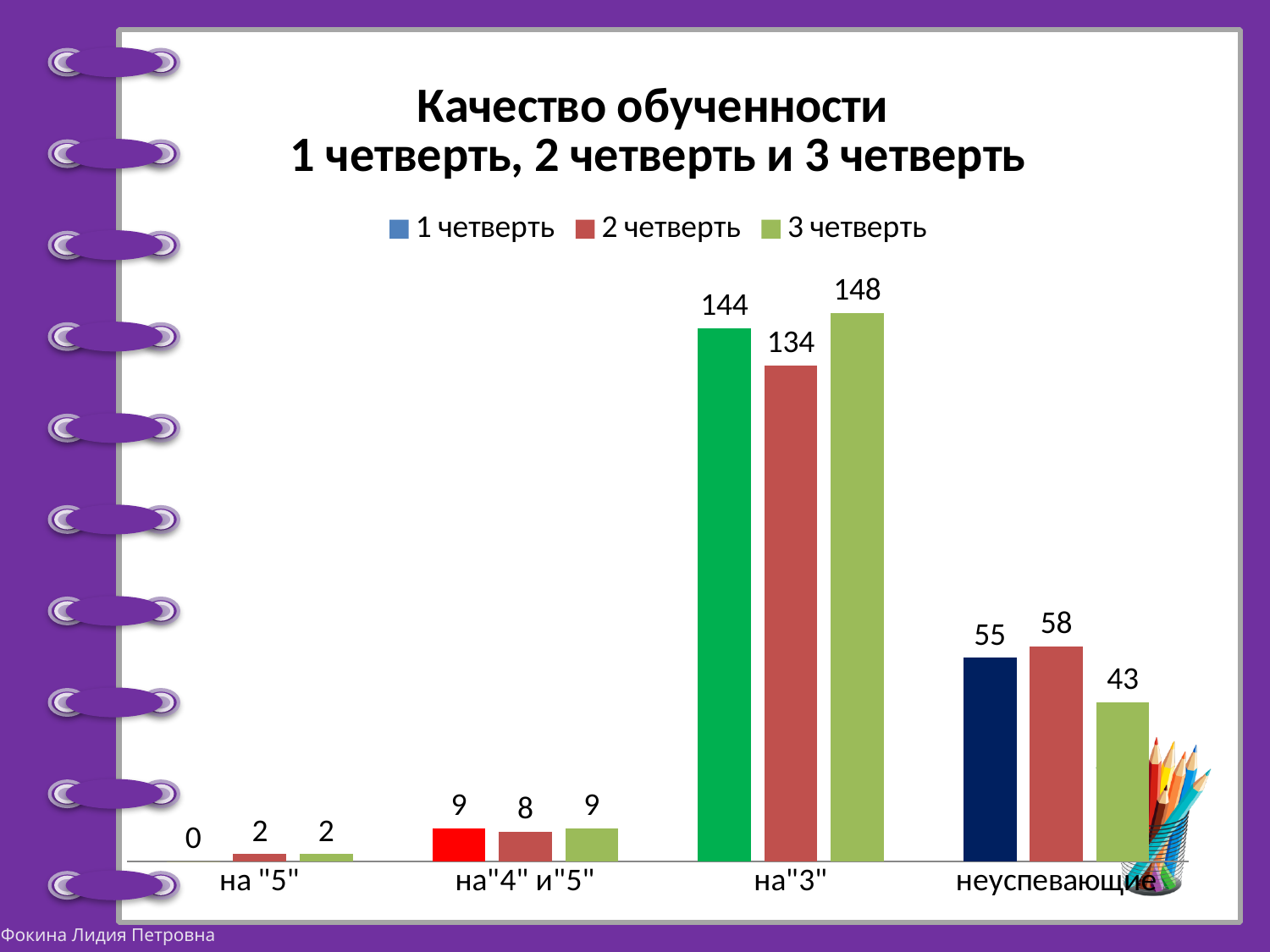
How many categories are shown on the x axis? 4 What kind of chart is shown on the slide? bar chart What is the value for 2 четверть in the неуспевающие category? 58 What is the difference between the 3 четверть and 2 четверть values in the на"3" category? 14 In the неуспевающие category, which is larger: the value for 2 четверть or for 3 четверть? 2 четверть What is the value for 1 четверть in the на "5" category? 0 What is the value for 2 четверть in the на"4" и"5" category? 8 What is the value for 3 четверть in the на"3" category? 148 Which category has the lowest value for 3 четверть? на "5" Which category has the highest value for 1 четверть? на"3" How many series does the legend list? 3 What is the difference between the 1 четверть and 3 четверть values in the неуспевающие category? 12